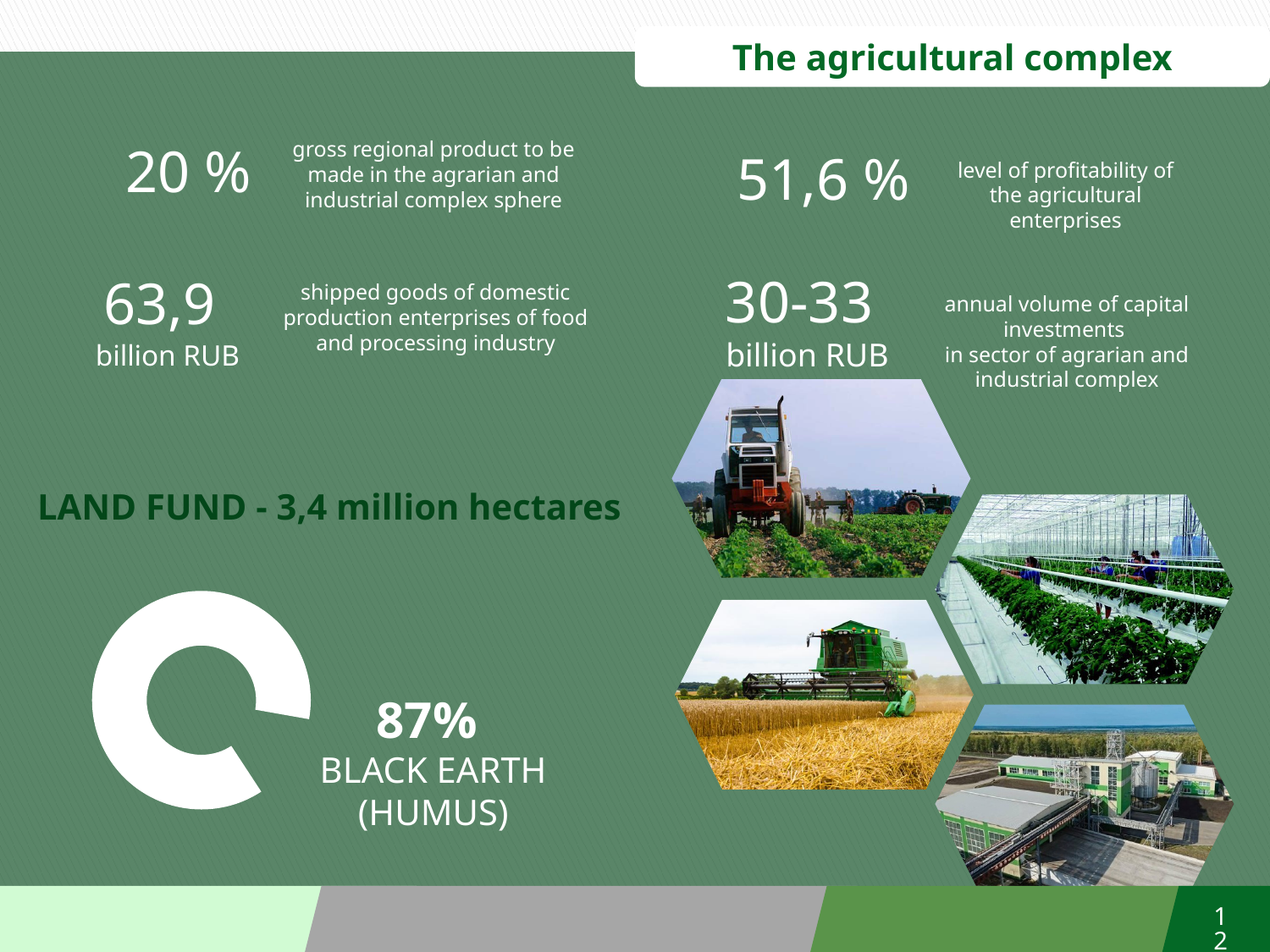
What category does the donut chart's 87% slice represent? Black earth (humus) What value is printed next to the donut chart? 87% Is the share shown in the donut chart greater or less than 50%? greater What share of the land fund is black earth (humus) according to the donut chart? 87% What kind of chart is shown at the bottom left of the slide? Donut chart How many labelled slices does the donut chart have? 1 What is the total land fund that the donut chart refers to, as stated on the slide? 3,4 million hectares